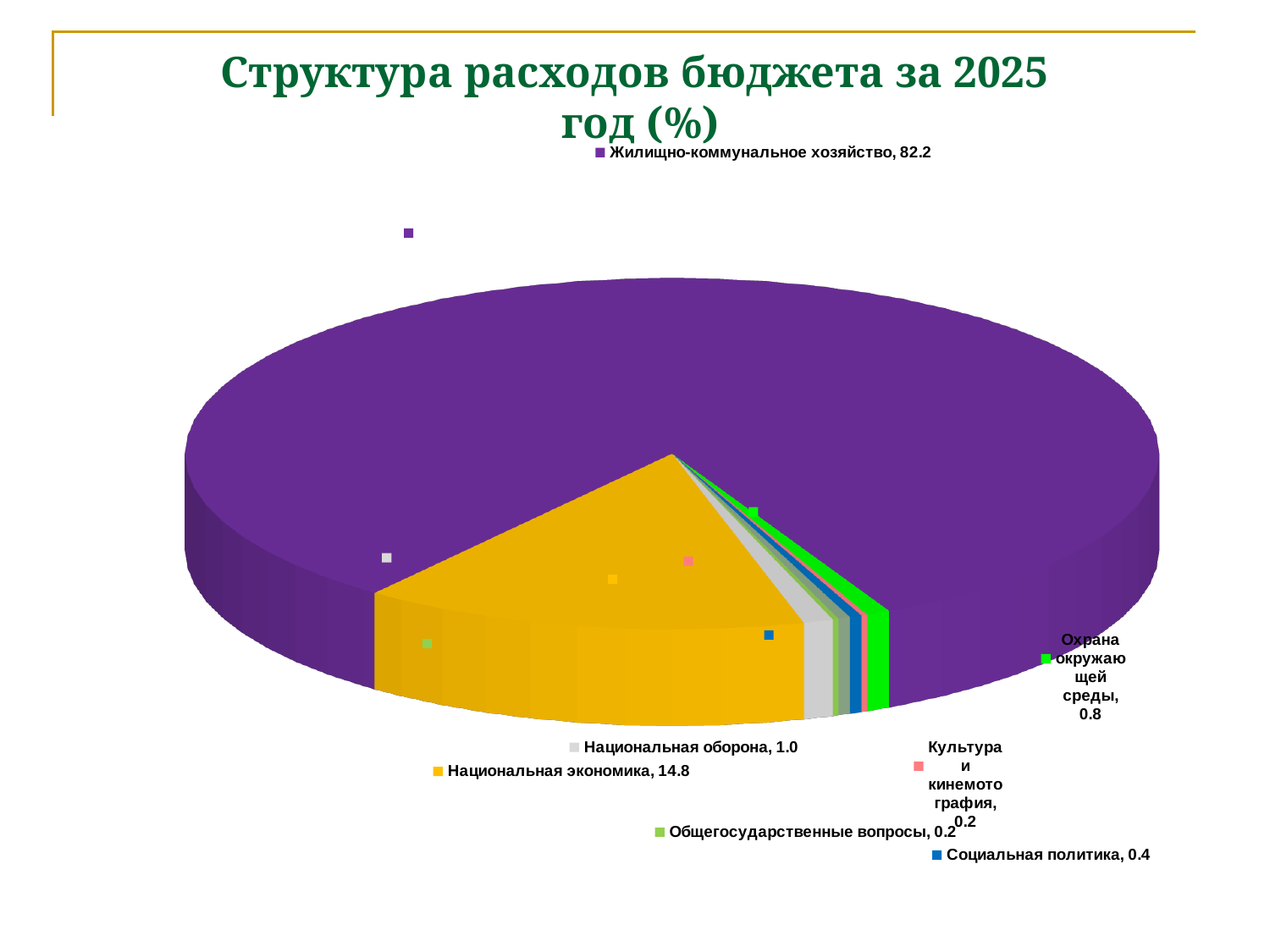
What is the value for Национальная экономика? 14.8 What is the value for Социальная политика? 0.4 What is the difference between the values for Жилищно-коммунальное хозяйство and Национальная экономика? 67.4 What is the value for Охрана окружающей среды? 0.8 Which category has the largest share of the pie? Жилищно-коммунальное хозяйство What is the value for Жилищно-коммунальное хозяйство? 82.2 Which is larger, Национальная оборона or Охрана окружающей среды? Национальная оборона What is the value for Национальная оборона? 1.0 What is the title of the chart? Структура расходов бюджета за 2025 год (%) What colour is the slice for Национальная экономика? yellow What kind of chart is shown on the slide? pie chart What is the difference between the values for Национальная экономика and Национальная оборона? 13.8